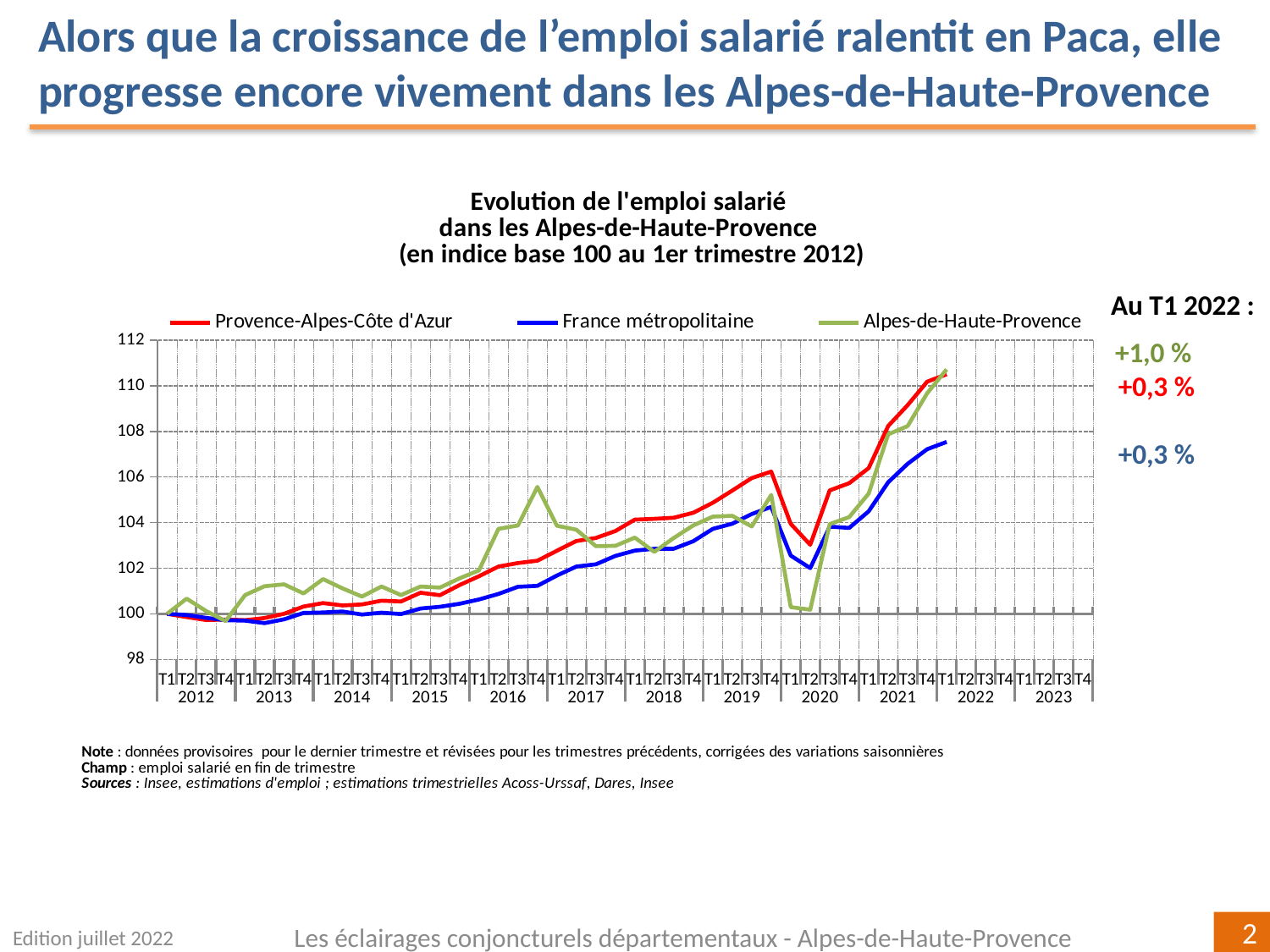
According to the annotation, what is the change at T1 2022 for Alpes-de-Haute-Provence? +1,0 % Which series has the lowest value at T2 2020? Alpes-de-Haute-Provence According to the annotation, what is the change at T1 2022 for Provence-Alpes-Côte d'Azur? +0,3 % Is the value for France métropolitaine at T1 2022 greater or less than 108? less Overall, do the series rise or fall between T1 2012 and T1 2022? rise What is the index value of all three series at T1 2012? 100 What is the title of the chart? Evolution de l'emploi salarié dans les Alpes-de-Haute-Provence (en indice base 100 au 1er trimestre 2012) Which series is drawn in blue? France métropolitaine How many series does the legend list? 3 Is the value for Alpes-de-Haute-Provence at T4 2016 greater or less than 104? greater What kind of chart is shown on the slide? line chart Which series has the lowest value at T1 2022? France métropolitaine